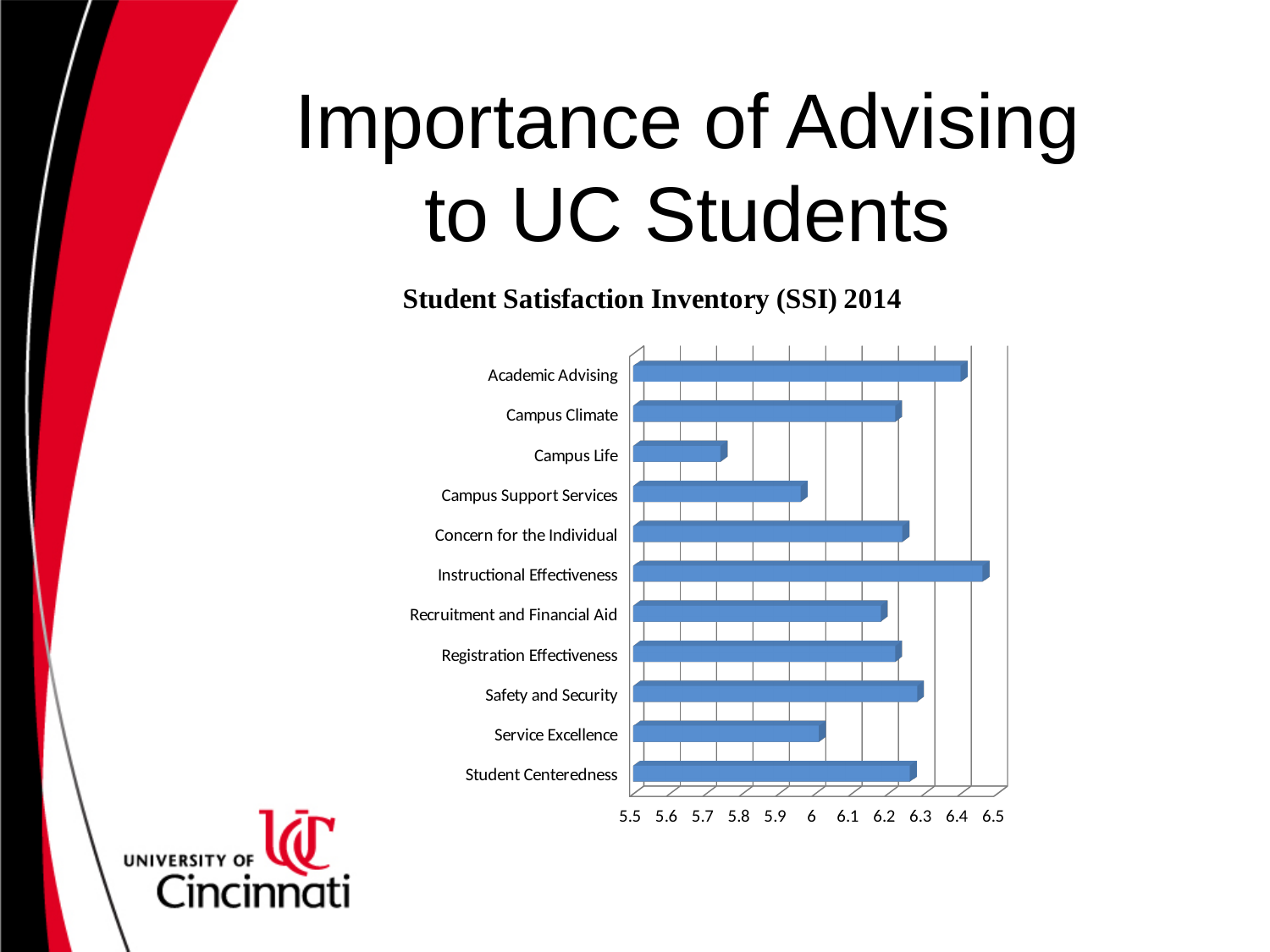
Is the value for Campus Life greater or less than 5.9? less Is the value for Instructional Effectiveness greater or less than 6.4? greater Which has a larger value, Service Excellence or Safety and Security? Safety and Security Which has a larger value, Campus Life or Campus Support Services? Campus Support Services Which category has the lowest value in the chart? Campus Life What is the title of the chart? Student Satisfaction Inventory (SSI) 2014 How many categories are plotted in the chart? 11 Is the value for Academic Advising greater or less than 6.3? greater What kind of chart is shown on the slide? Bar chart Which has a larger value, Academic Advising or Campus Climate? Academic Advising Which category has the highest value in the chart? Instructional Effectiveness